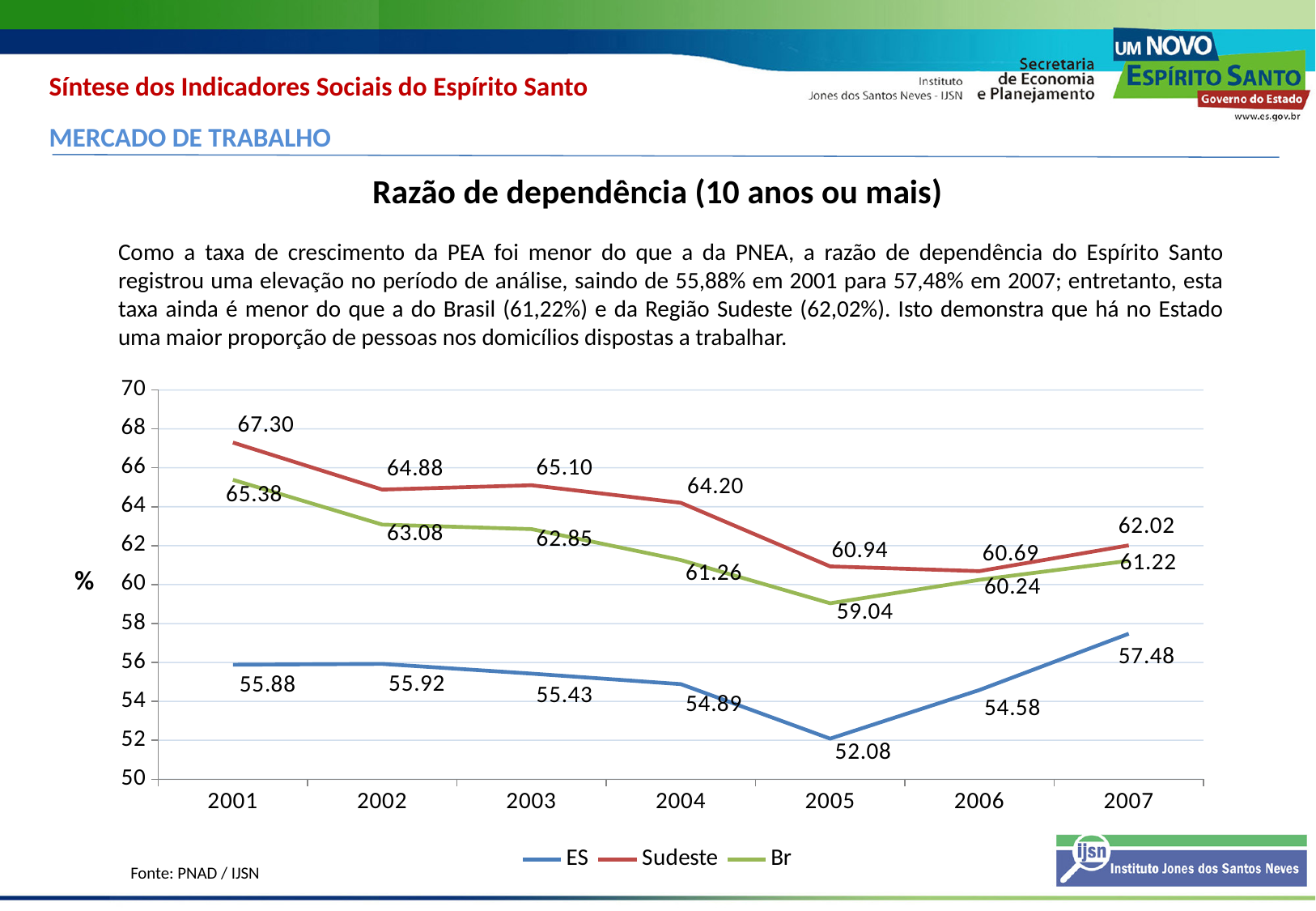
What type of chart is shown on the slide? line chart What is the value for Sudeste in 2001? 67.30 What is the value for ES in 2005? 52.08 In which year is the ES series at its lowest? 2005 In which year is the Sudeste series at its highest? 2001 What is the title of the chart? Razão de dependência (10 anos ou mais) How many series does the legend list? 3 How many years are plotted on the x axis? 7 What is the value for Br in 2007? 61.22 Does the ES series rise or fall from 2005 to 2007? rise Which is larger in 2003, the Sudeste value or the Br value? Sudeste What is the difference between the Sudeste and ES values in 2007? 4.54